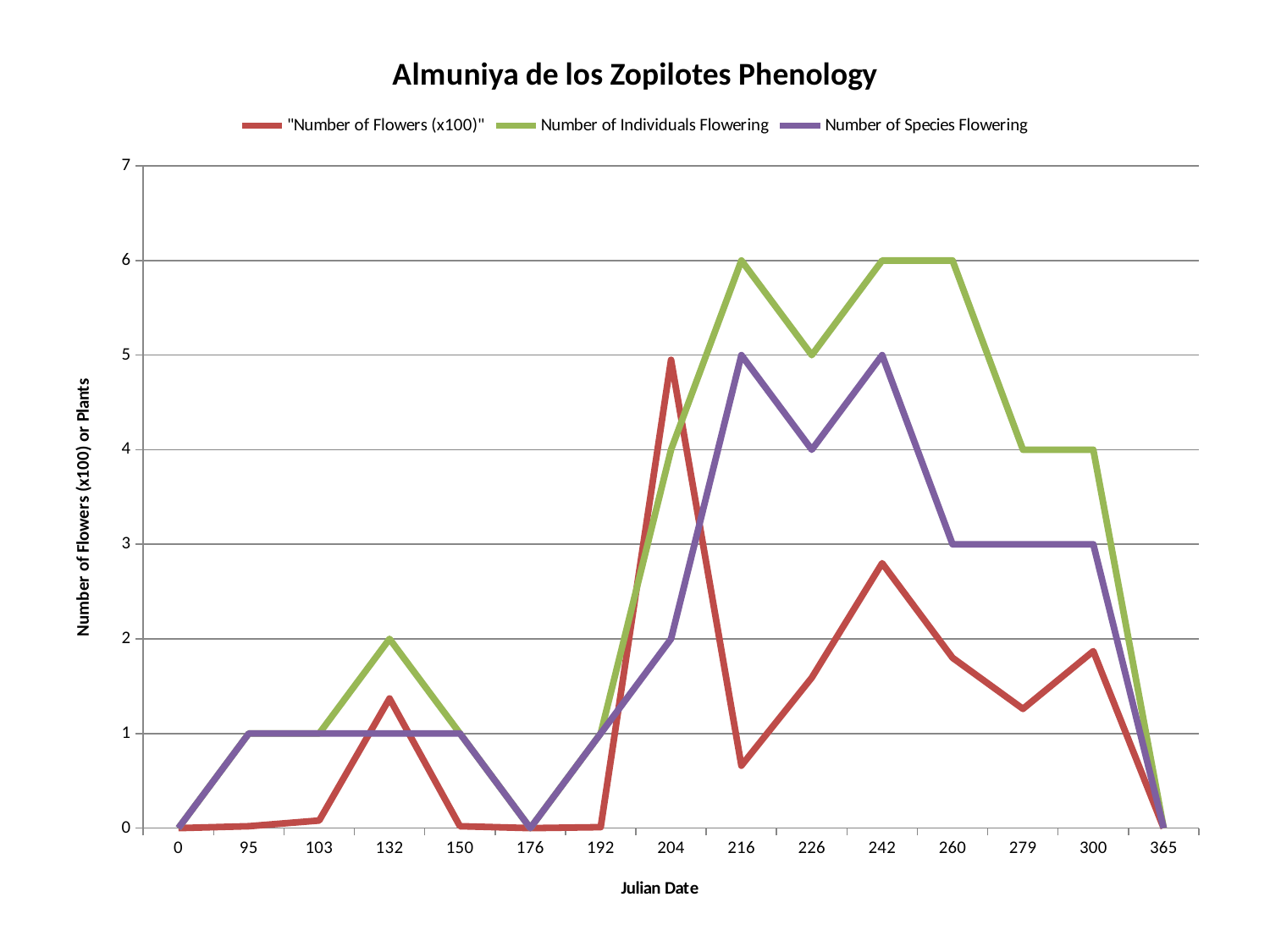
What is the title of the x axis? Julian Date What kind of chart is shown on the slide? line chart How many series does the legend list? 3 What is the value of Number of Individuals Flowering at Julian Date 132? 2 At Julian Date 260, which is larger: Number of Individuals Flowering or Number of Species Flowering? Number of Individuals Flowering At which Julian Date does the Number of Flowers (x100) series reach its highest value? 204 What is the value of Number of Individuals Flowering at Julian Date 216? 6 What is the difference between Number of Individuals Flowering and Number of Species Flowering at Julian Date 226? 1 Is the value of Number of Flowers (x100) at Julian Date 204 greater or less than 4? greater What is the value of Number of Species Flowering at Julian Date 216? 5 What is the value of Number of Species Flowering at Julian Date 260? 3 How many Julian Date points are plotted along the x axis? 15